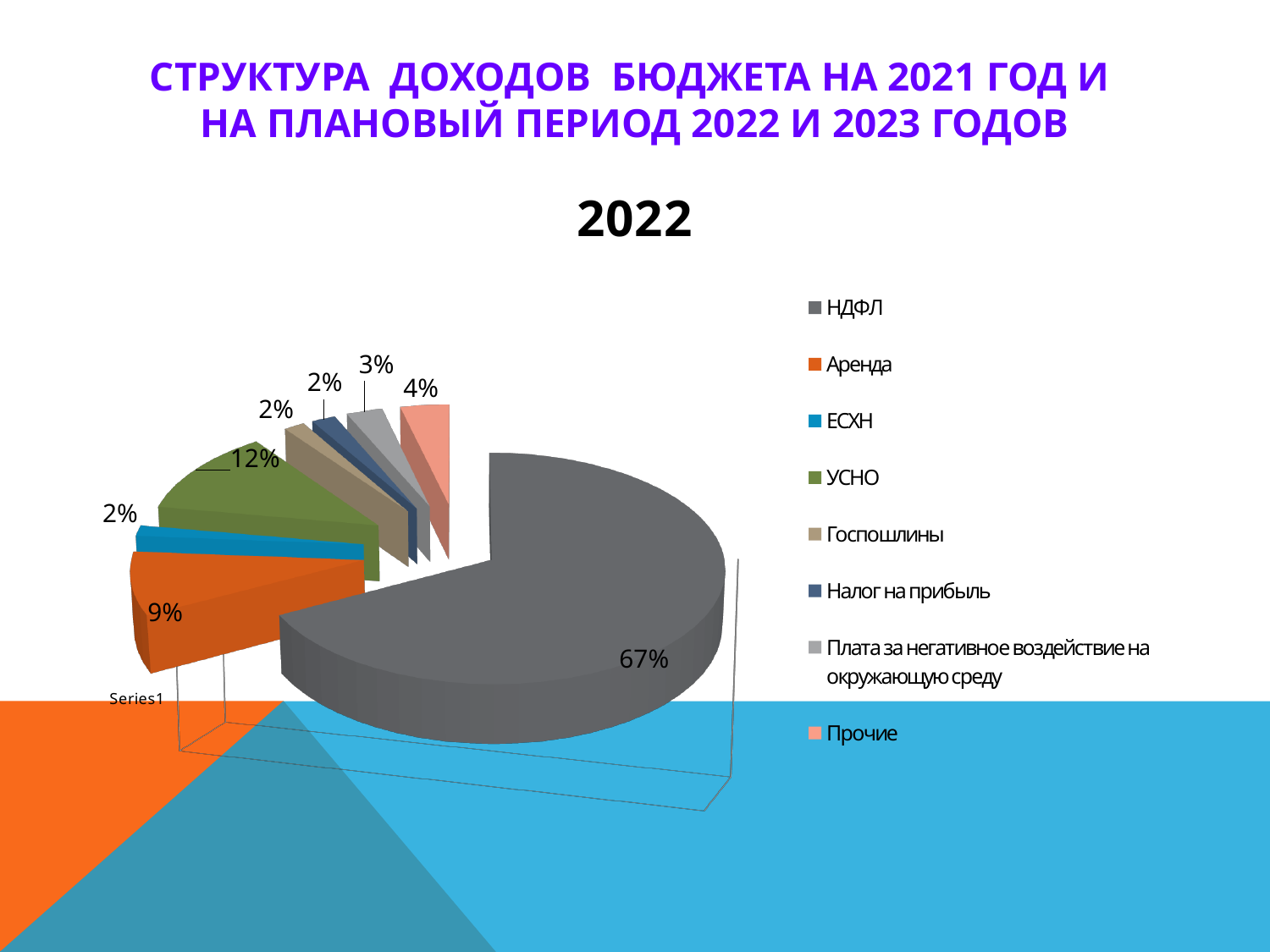
What type of chart is shown on the slide? Pie chart What is the combined share of Аренда and Прочие? 13% What share of the pie does НДФЛ have? 67% What share of the pie does Аренда have? 9% What share of the pie does УСНО have? 12% Which category has the largest share of the pie? НДФЛ What share of the pie does Плата за негативное воздействие на окружающую среду have? 3% What is the chart's title? 2022 What share of the pie does Прочие have? 4% Which is larger, the share of Аренда or the share of УСНО? УСНО How many categories does the legend list? 8 What is the difference between the shares of НДФЛ and УСНО? 55%